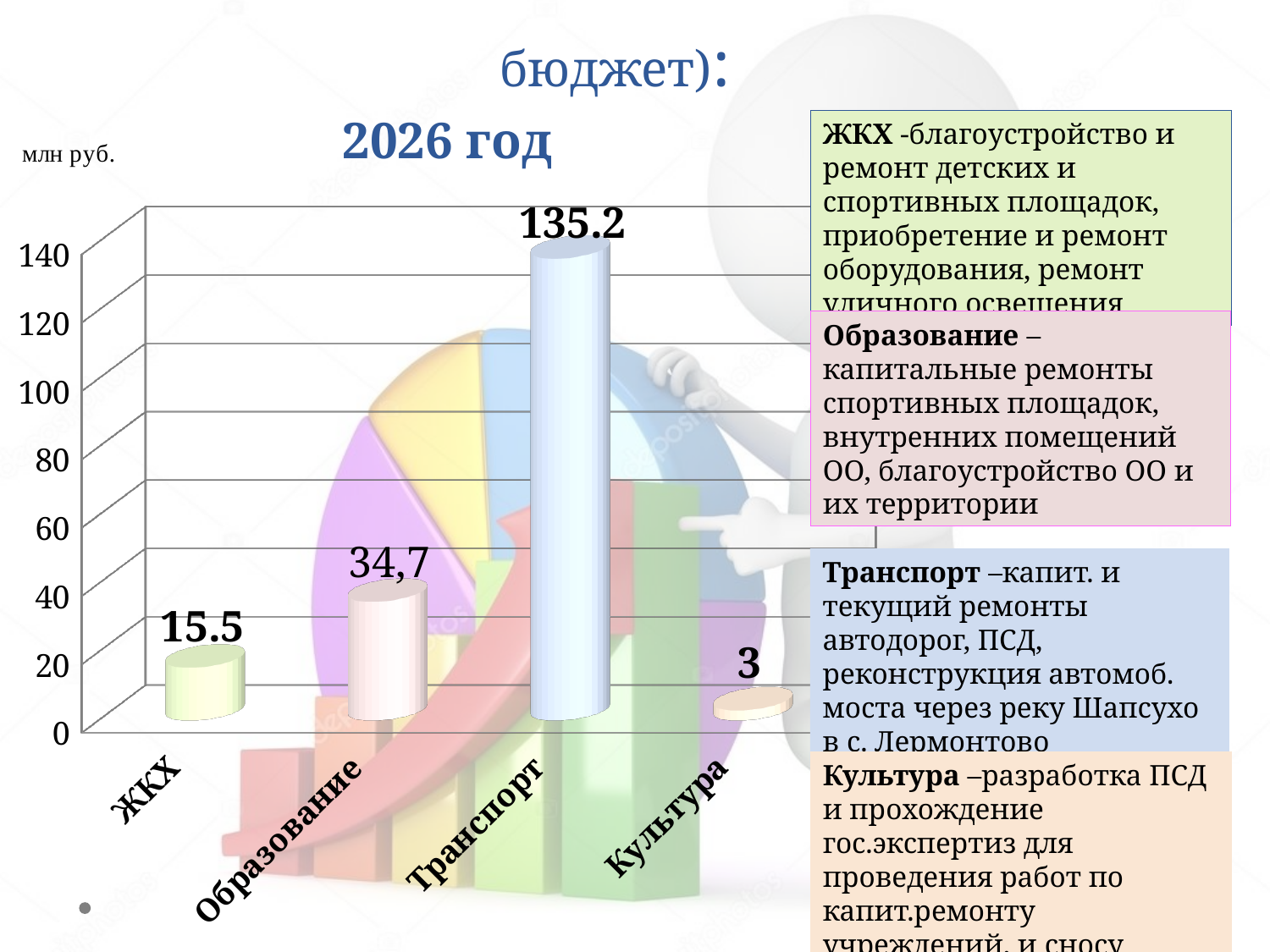
What is the difference between the values for ЖКХ and Культура in the 2026 год chart? 12.5 Which category has the lowest value in the 2026 год chart? Культура What is the value for Образование in the 2026 год chart? 34,7 What is the value for Культура in the 2026 год chart? 3 Is the value for Транспорт in the 2026 год chart greater or less than 120? greater Which is larger in the 2026 год chart, the value for Образование or the value for ЖКХ? Образование What unit is shown for the values in the 2026 год chart? млн руб. What is the value for ЖКХ in the 2026 год chart? 15.5 What is the value for Транспорт in the 2026 год chart? 135.2 Which category has the highest value in the 2026 год chart? Транспорт How many categories are shown in the 2026 год chart? 4 What is the difference between the values for Транспорт and ЖКХ in the 2026 год chart? 119.7